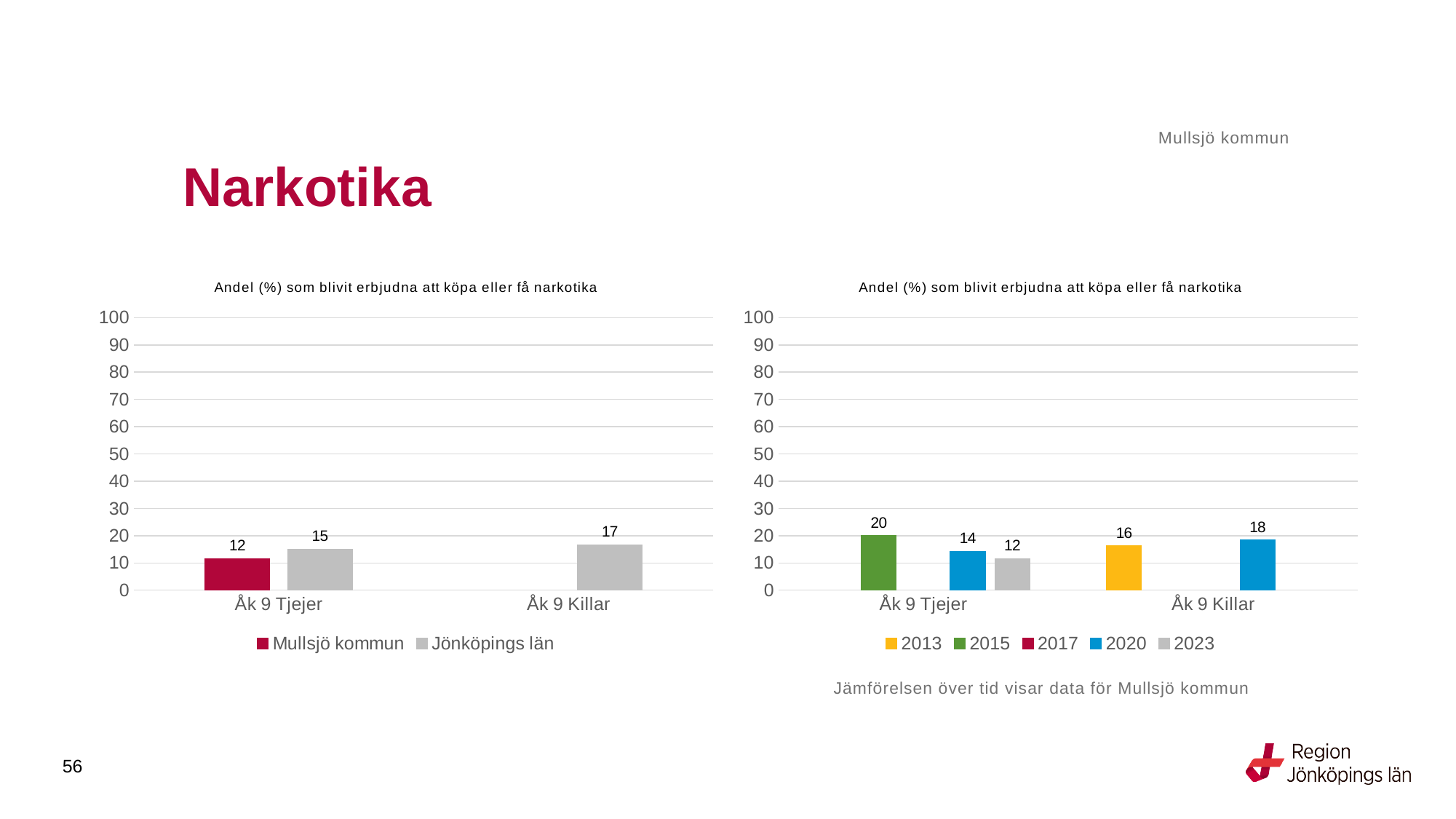
In the right chart, what is the value for 2020 for Åk 9 Killar? 18 In the left chart, which is larger for Åk 9 Tjejer: Mullsjö kommun or Jönköpings län? Jönköpings län In the right chart, which year has the highest value for Åk 9 Tjejer? 2015 In the right chart, what is the value for 2015 for Åk 9 Tjejer? 20 How many series does the legend of the right chart list? 5 What kind of chart is the left chart? Bar chart In the right chart, is the value for 2013 for Åk 9 Killar greater or less than 20? less In the right chart, what is the difference between 2015 and 2023 for Åk 9 Tjejer? 8 In the left chart, what is the value for Jönköpings län for Åk 9 Killar? 17 In the left chart, what is the difference between Jönköpings län and Mullsjö kommun for Åk 9 Tjejer? 3 How many series does the legend of the left chart list? 2 In the left chart, what is the value for Mullsjö kommun for Åk 9 Tjejer? 12